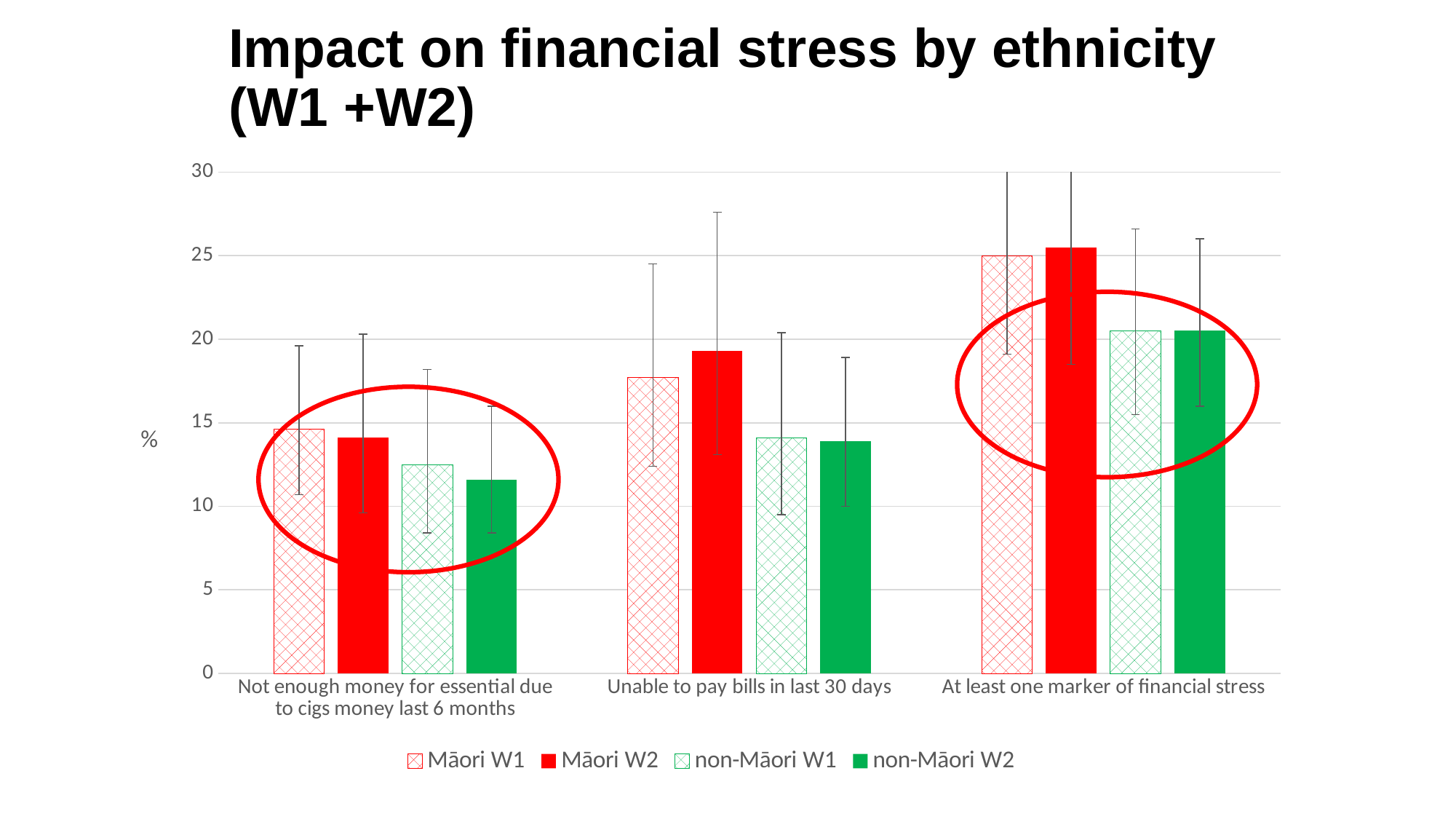
Is the value for Māori W2 in 'Unable to pay bills in last 30 days' greater or less than 15? greater How many categories are shown on the x axis? 3 In 'Unable to pay bills in last 30 days', which is larger: Māori W2 or non-Māori W2? Māori W2 How many series does the legend list? 4 For which category is the Māori W2 bar highest? At least one marker of financial stress What kind of chart is shown on the slide? bar chart What is the label on the y axis? % Is the value for non-Māori W1 in 'At least one marker of financial stress' greater or less than 25? less What is the title of the chart? Impact on financial stress by ethnicity (W1 +W2) Is the value for non-Māori W2 in 'Not enough money for essential due to cigs money last 6 months' greater or less than 15? less For which category is the non-Māori W2 bar lowest? Not enough money for essential due to cigs money last 6 months